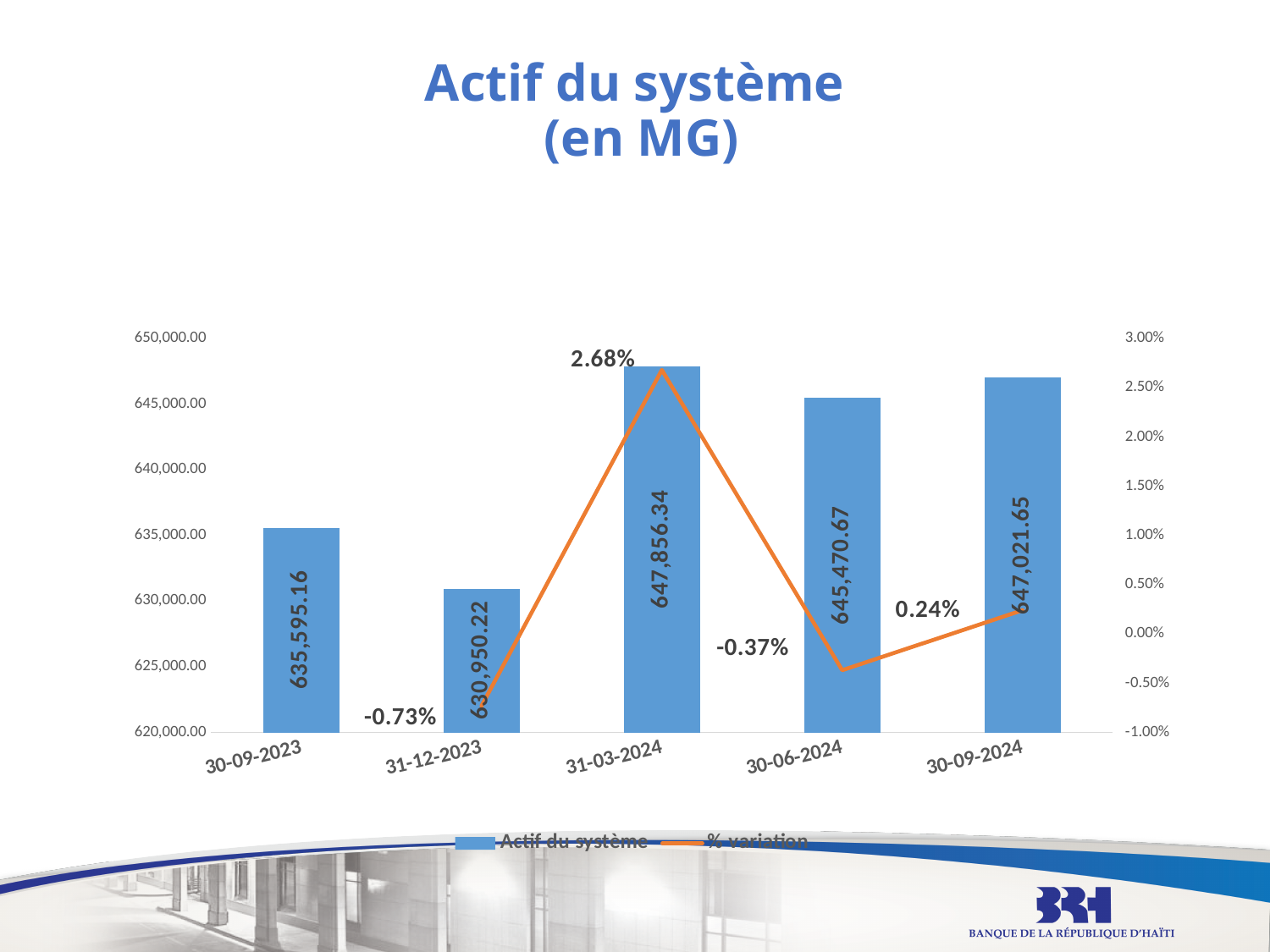
Is the value of Actif du système on 30-09-2023 greater or less than 640,000.00? less Which is larger, Actif du système on 30-06-2024 or on 30-09-2024? 30-09-2024 What is the % variation shown for 31-12-2023? -0.73% On which date is Actif du système the lowest? 31-12-2023 What is the value of Actif du système on 30-09-2023? 635,595.16 What is the difference between Actif du système on 31-03-2024 and on 31-12-2023? 16,906.12 What is the % variation shown for 30-09-2024? 0.24% How many series does the legend list? 2 How many dates are shown on the x axis? 5 What is the value of Actif du système on 31-03-2024? 647,856.34 On which date is Actif du système the highest? 31-03-2024 Which % variation value is the highest? 2.68%